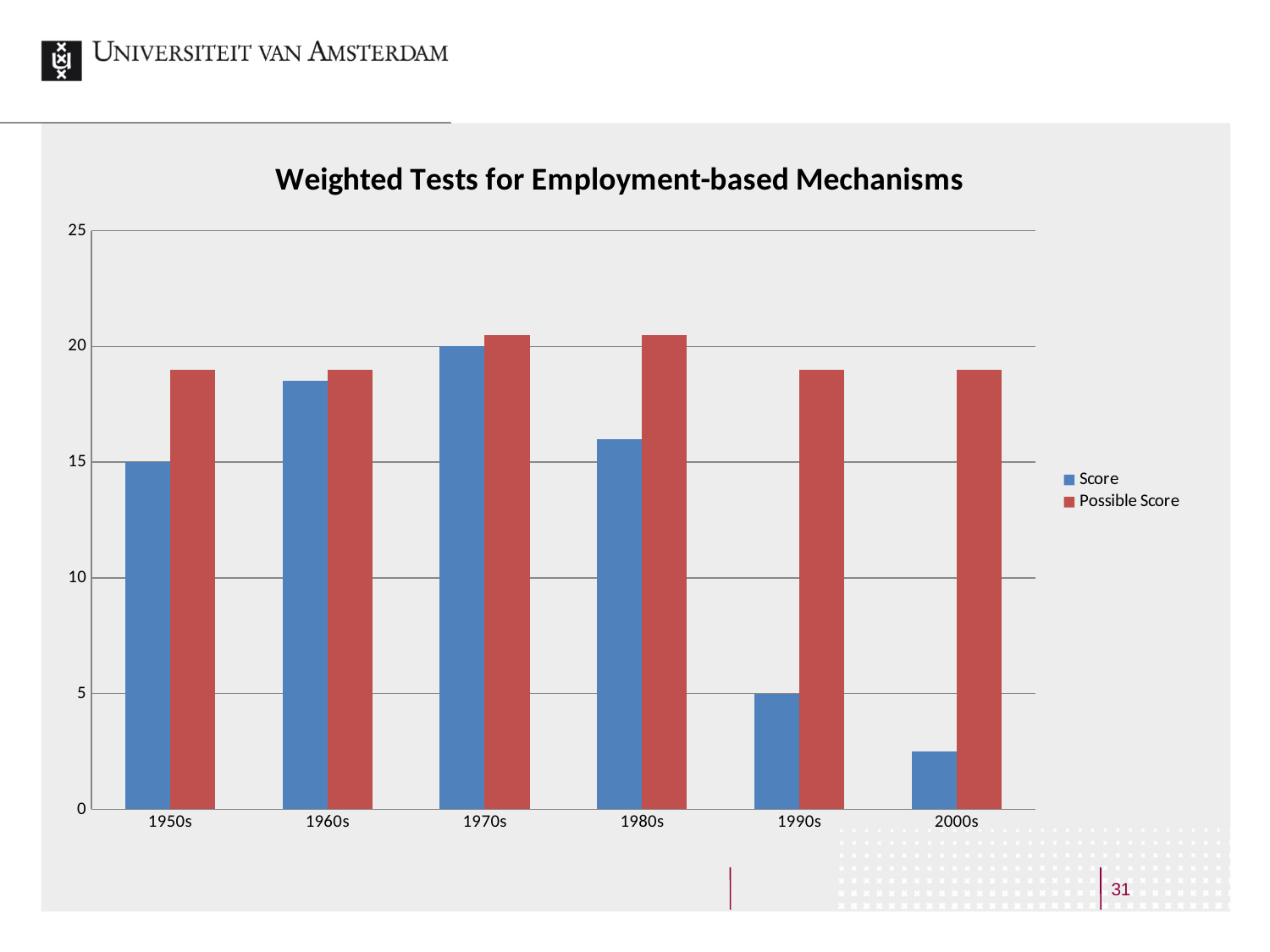
What is the title of the chart? Weighted Tests for Employment-based Mechanisms Does the Score rise or fall from the 1970s to the 2000s? fall What type of chart is shown on the slide? bar chart What is the Score for the 1990s? 5 Which decade has the highest Score? 1970s Which decade has the lowest Score? 2000s Which is larger, the Score for the 1960s or the Score for the 1980s? 1960s What is the Score for the 1970s? 20 Is the Score for the 2000s greater or less than 5? less How many series does the legend list? 2 How many decades are shown on the x axis? 6 Is the Score for the 1960s greater or less than 15? greater